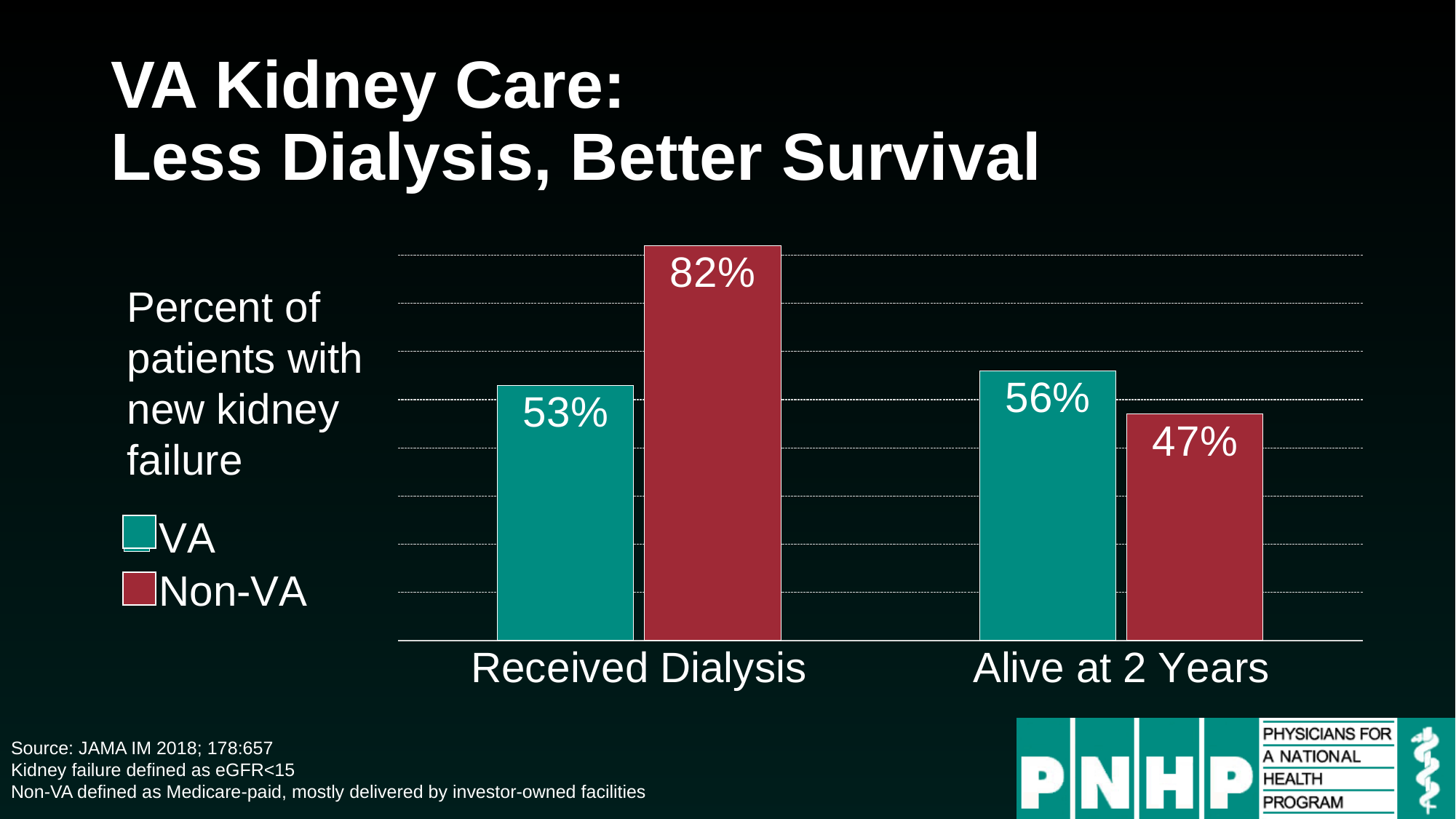
What is the difference in percentage points between Non-VA and VA patients who received dialysis? 29 Which group had a higher percentage alive at 2 years, VA or Non-VA? VA What percent of VA patients were alive at 2 years? 56% How many categories are shown on the x axis of the chart? 2 How many series does the legend list? 2 What is the difference in percentage points between VA and Non-VA patients alive at 2 years? 9 Which bar in the chart has the lowest value? Non-VA, Alive at 2 Years What kind of chart is shown on the slide? Bar chart What percent of VA patients received dialysis? 53% Which bar in the chart has the highest value? Non-VA, Received Dialysis What percent of Non-VA patients were alive at 2 years? 47% What percent of Non-VA patients received dialysis? 82%